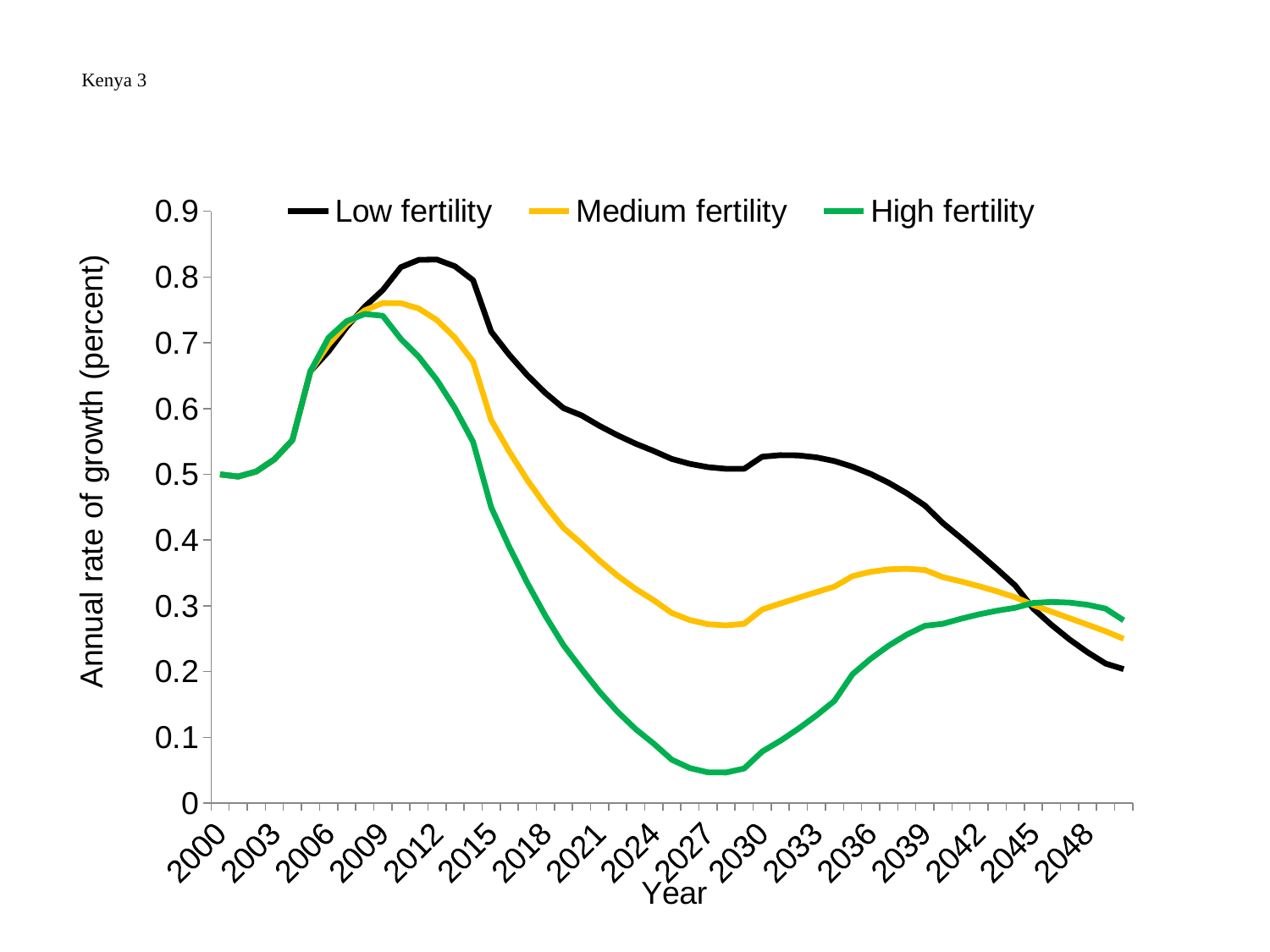
Is the value for High fertility in 2000 greater or less than 0.4? greater Which series reaches the highest value anywhere on the chart? Low fertility Is the value for Low fertility in 2012 greater or less than 0.8? greater How many series does the legend list? 3 In 2021, which series has the higher value, Medium fertility or High fertility? Medium fertility What is the title of the vertical axis? Annual rate of growth (percent) Is the value for Medium fertility in 2039 greater or less than 0.3? greater What are the three series named in the legend? Low fertility, Medium fertility, High fertility What kind of chart is shown on the slide? line chart Does the Low fertility line rise or fall between 2033 and 2048? fall In 2027, which series has the higher value, Low fertility or High fertility? Low fertility